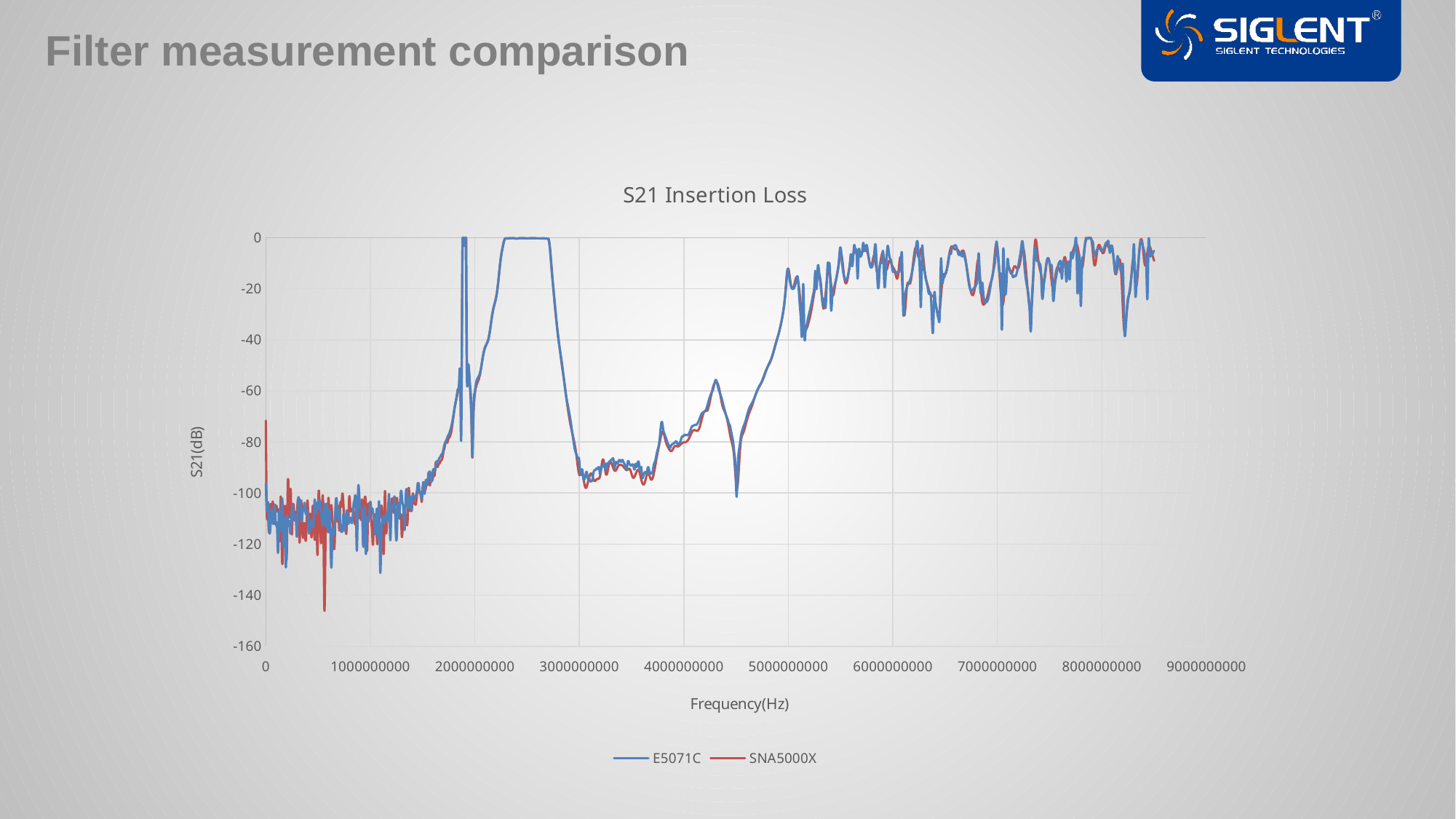
Is the SNA5000X value at 7000000000 Hz greater or less than -40 dB? greater How many series does the legend list? 2 What is the label of the vertical axis? S21(dB) Do the values rise or fall as frequency increases from 2500000000 Hz to 3000000000 Hz? fall Is the E5071C value at 3500000000 Hz greater or less than -100 dB? greater Is the E5071C value at 4500000000 Hz greater or less than -80 dB? less Do the values rise or fall as frequency increases from 1000000000 Hz to 2500000000 Hz? rise What is the title of the chart? S21 Insertion Loss Which series reaches the lowest value anywhere on the chart? SNA5000X What kind of chart is shown on the slide? line chart